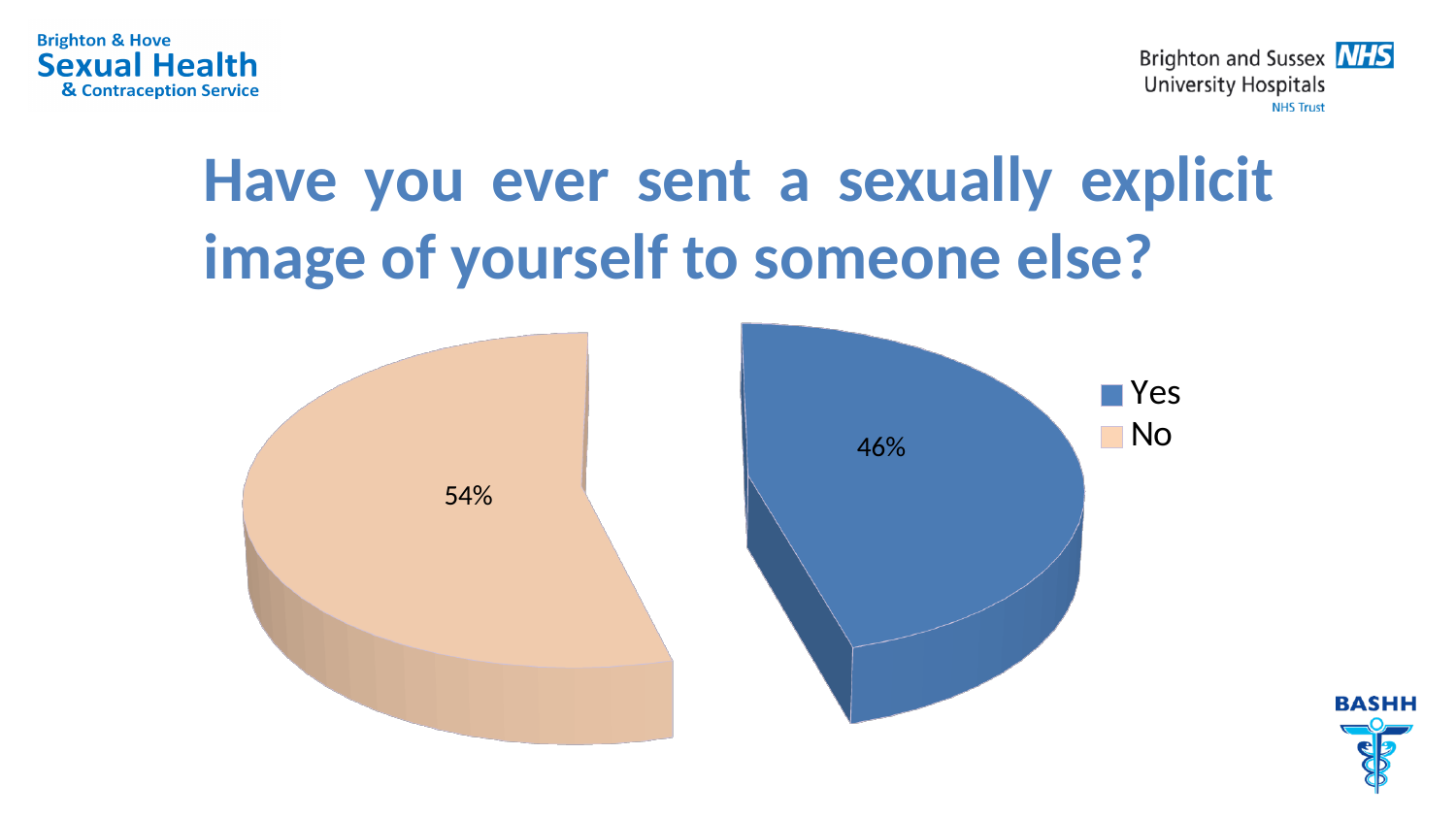
How many slices does the pie chart have? 2 What percentage of respondents answered Yes? 46% What colour is the Yes slice? blue What is the difference in percentage points between the No and Yes slices? 8 Which response has the larger share of the pie? No What kind of chart is shown on the slide? pie chart Which response has the smaller share of the pie? Yes What percentage of respondents answered No? 54% How many entries does the legend list? 2 Is the Yes slice larger or smaller than the No slice? smaller What share of the pie does the No slice represent? 54% What question does the chart title ask? Have you ever sent a sexually explicit image of yourself to someone else?